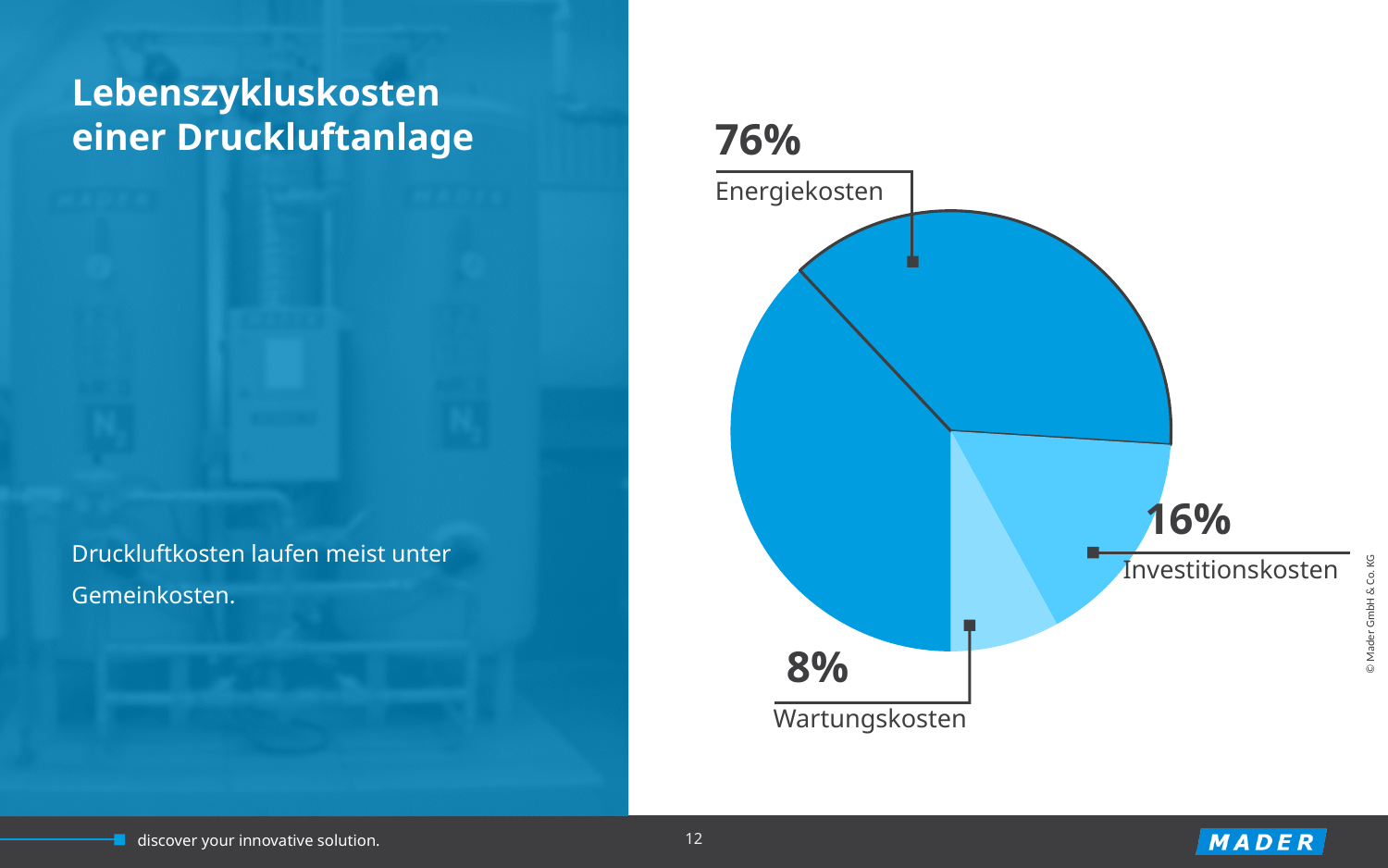
What share of the pie chart is Energiekosten? 76% How many categories are shown in the pie chart? 3 What is the title of the slide containing the pie chart? Lebenszykluskosten einer Druckluftanlage What is the difference in percentage points between Energiekosten and Investitionskosten? 60 Which is larger, Investitionskosten or Wartungskosten? Investitionskosten What share of the pie chart is Investitionskosten? 16% Which category has the smallest slice of the pie chart? Wartungskosten What share of the pie chart is Wartungskosten? 8% What is the combined share of Investitionskosten and Wartungskosten? 24% What is the difference in percentage points between Investitionskosten and Wartungskosten? 8 What kind of chart is shown on the slide? Pie chart Which category has the largest slice of the pie chart? Energiekosten